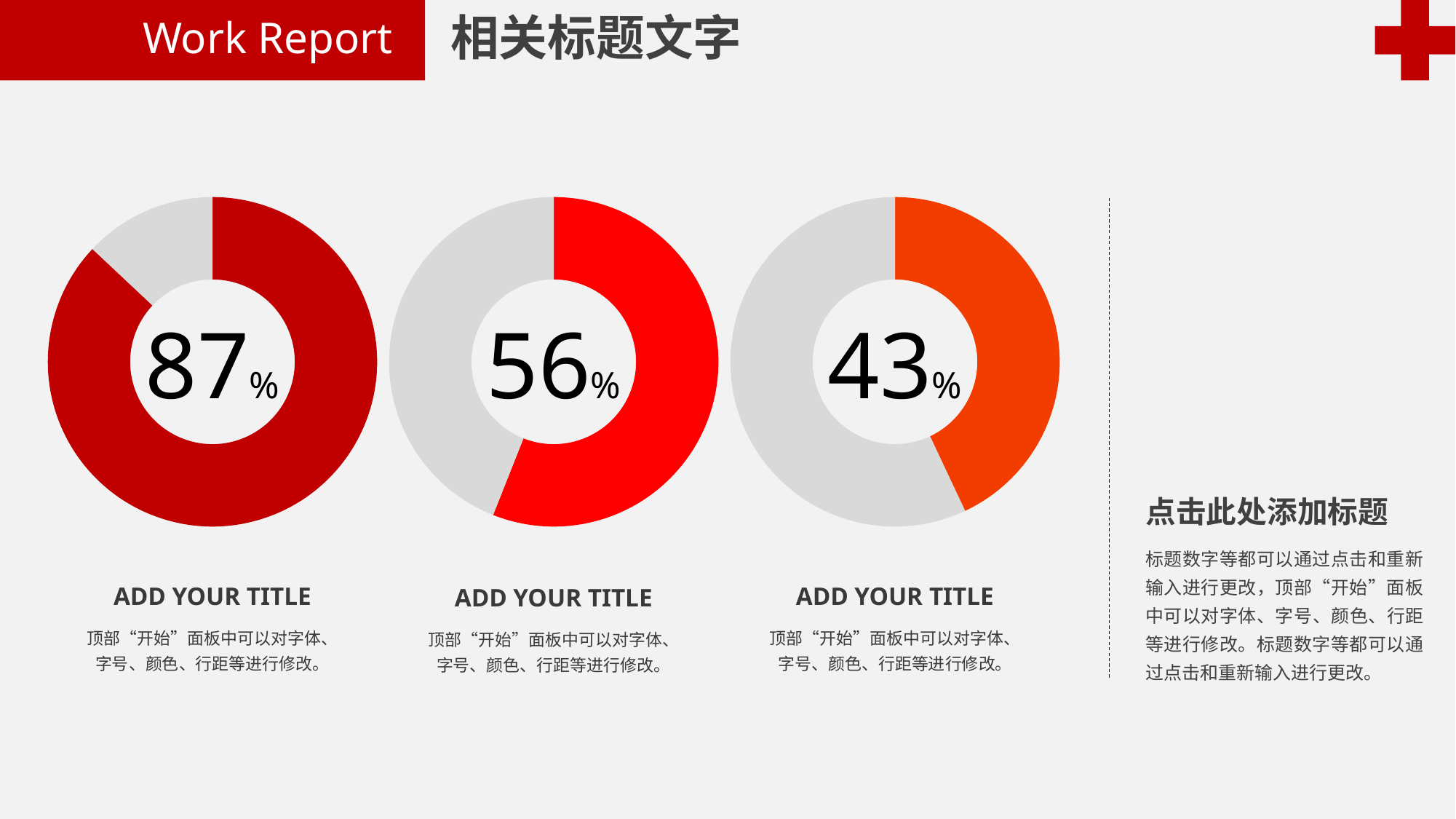
Which of the three donut charts shows the highest percentage: left, middle or right? left Is the percentage in the middle donut chart larger or smaller than the percentage in the right donut chart? larger What kind of chart is used to show the three percentages on the slide? donut chart What is the difference between the percentage in the middle donut chart and the percentage in the right donut chart? 13% Which of the three donut charts shows the lowest percentage: left, middle or right? right How many donut charts are on the slide? 3 What percentage is shown in the centre of the right donut chart? 43% What is the label printed below each of the three donut charts? ADD YOUR TITLE What is the difference between the percentage in the left donut chart and the percentage in the right donut chart? 44% What colour is the filled portion of the right donut chart? orange What percentage is shown in the centre of the left donut chart? 87% What percentage is shown in the centre of the middle donut chart? 56%